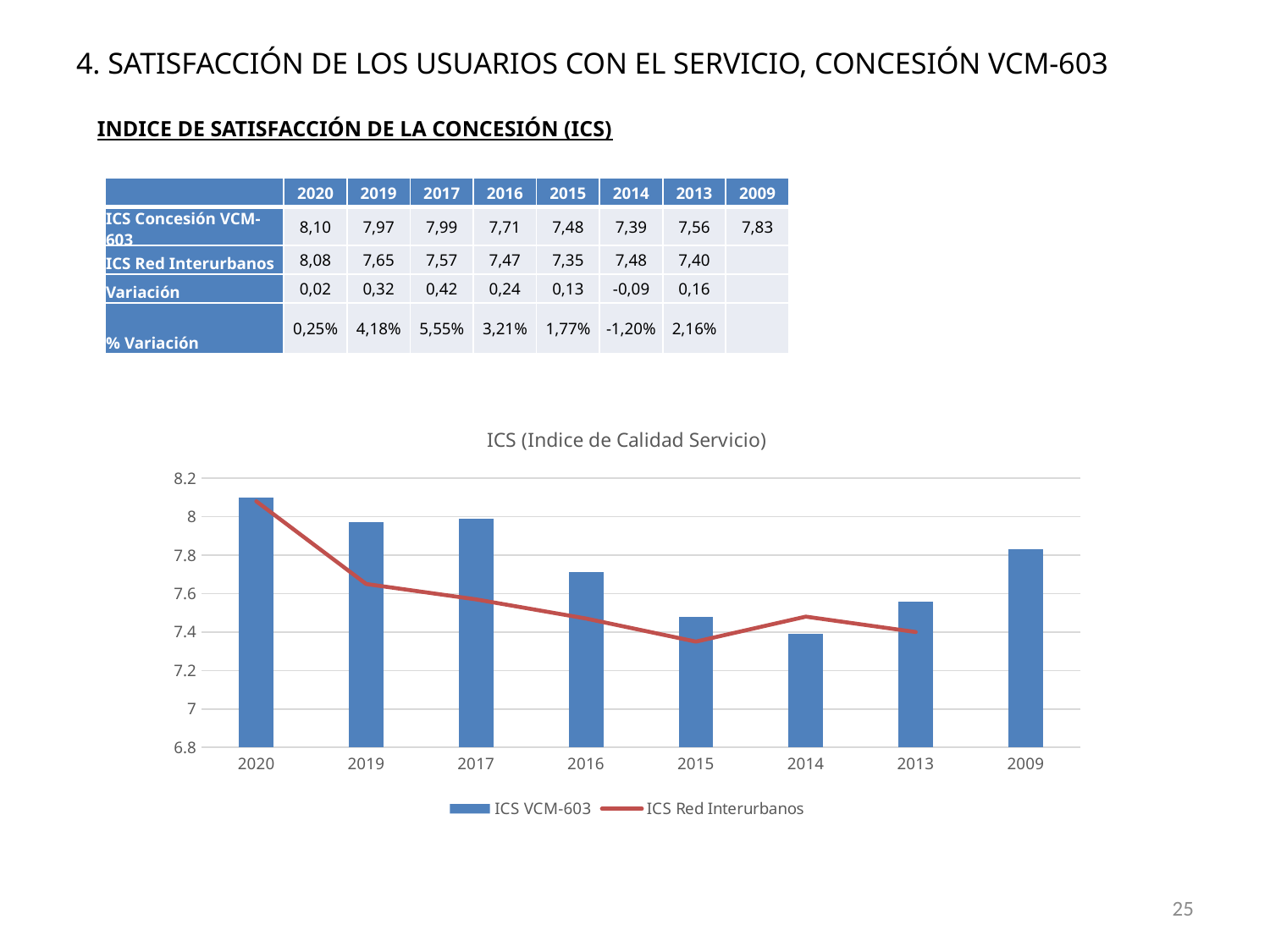
Is the ICS VCM-603 value for 2020 greater or less than 8? greater What kind of chart is shown on the slide? A bar chart with a line series In 2019, which is larger: ICS VCM-603 or ICS Red Interurbanos? ICS VCM-603 What is the ICS Concesión VCM-603 value for 2019? 7,97 How many years are shown on the x axis of the chart? 8 What is the title of the chart? ICS (Indice de Calidad Servicio) Is the ICS VCM-603 value for 2015 greater or less than 7.6? less Which year has the highest ICS VCM-603 bar? 2020 Which year has the lowest ICS VCM-603 bar? 2014 What is the ICS Red Interurbanos value for 2017? 7,57 Does the ICS Red Interurbanos line rise or fall from 2020 to 2015? fall How many series does the chart legend list? 2